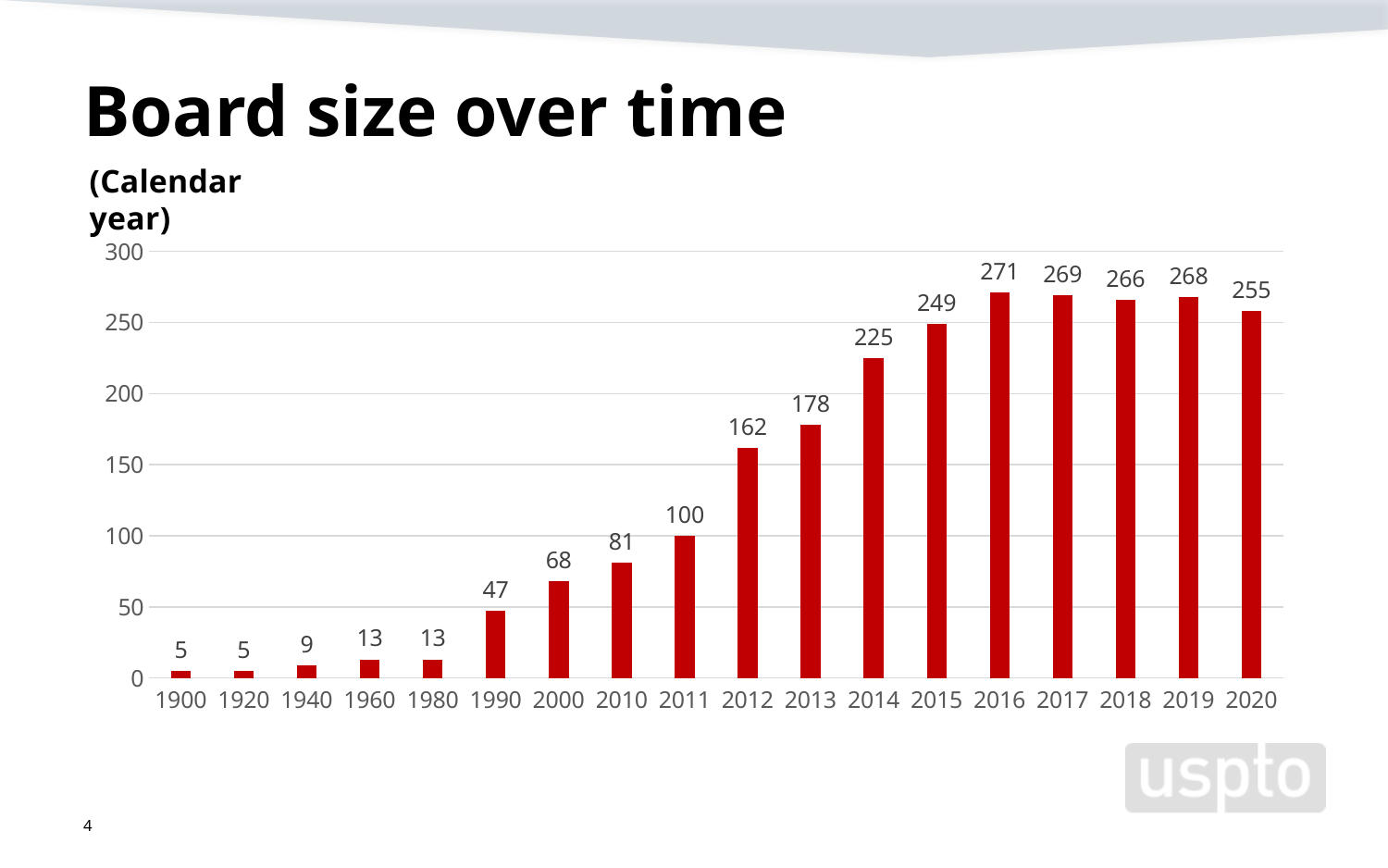
What is the board size for 2014? 225 Which years have the lowest board size? 1900 and 1920 What is the board size for 2020? 255 What kind of chart is shown on the slide? Bar chart Which year has the highest board size? 2016 Is the board size for 2015 greater or less than 200? greater How many years are shown on the x axis? 18 What is the difference in board size between 2013 and 2012? 16 Which is larger, the board size in 2011 or in 2000? 2011 What is the title of the chart? Board size over time What is the board size for 1990? 47 What is the difference in board size between 2016 and 2020? 16